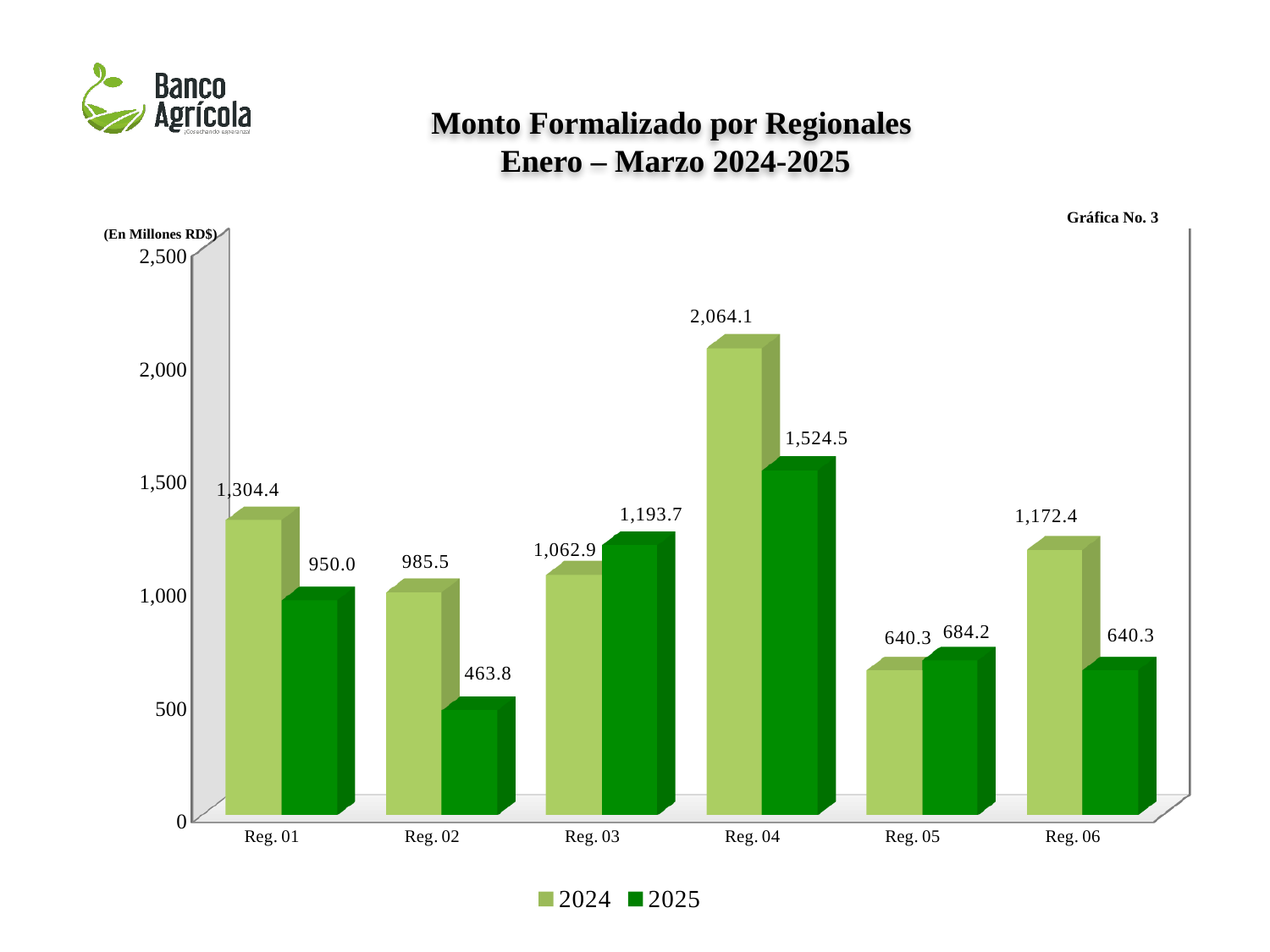
How many regions are shown on the x axis? 6 How many series does the legend list? 2 Is the 2024 value for Reg. 06 greater or less than 1,000? greater What is the difference between the 2024 and 2025 values for Reg. 04? 539.6 Which region has the lowest 2025 value? Reg. 02 What is the 2025 value for Reg. 03? 1,193.7 Which region has the highest 2024 value? Reg. 04 What is the 2025 value for Reg. 02? 463.8 What is the 2024 value for Reg. 04? 2,064.1 What kind of chart is shown on the slide? Bar chart What is the difference between the 2025 and 2024 values for Reg. 03? 130.8 Which is larger for Reg. 05, the 2024 value or the 2025 value? 2025